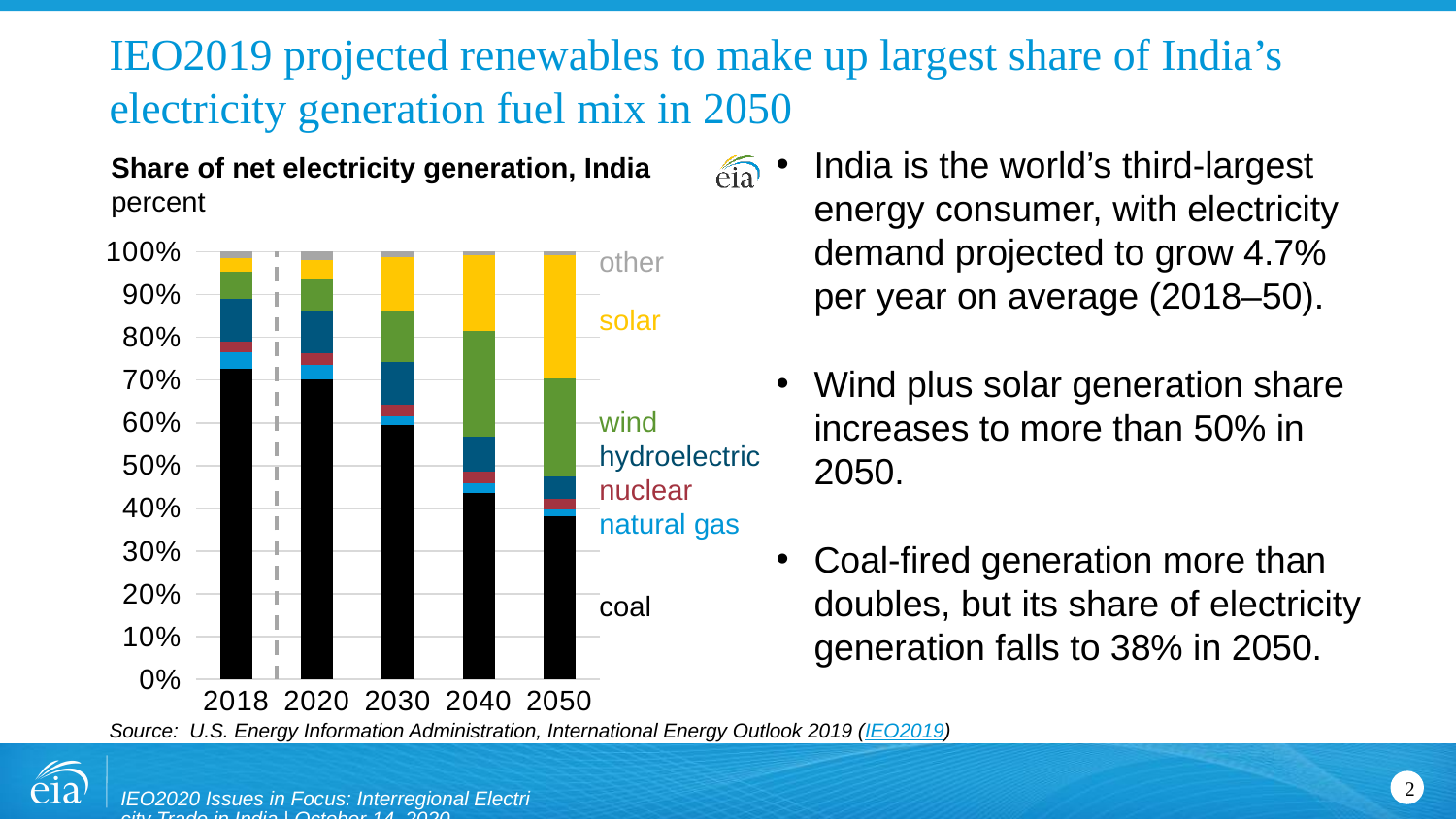
What is the title of the chart? Share of net electricity generation, India In which year is the coal share the highest? 2018 Is the solar share larger in 2018 or in 2050? 2050 In which year is the solar share the largest? 2050 In which year is the coal share the lowest? 2050 What kind of chart is shown on the slide? Stacked bar chart Is the coal share in 2050 greater or less than 40%? less Does the share of coal rise or fall from 2018 to 2050? Fall How many years are shown along the x axis of the chart? 5 Is the coal share in 2018 greater or less than 70%? greater How many fuel series are labelled on the chart? 7 Is the coal share in 2030 greater or less than 50%? greater